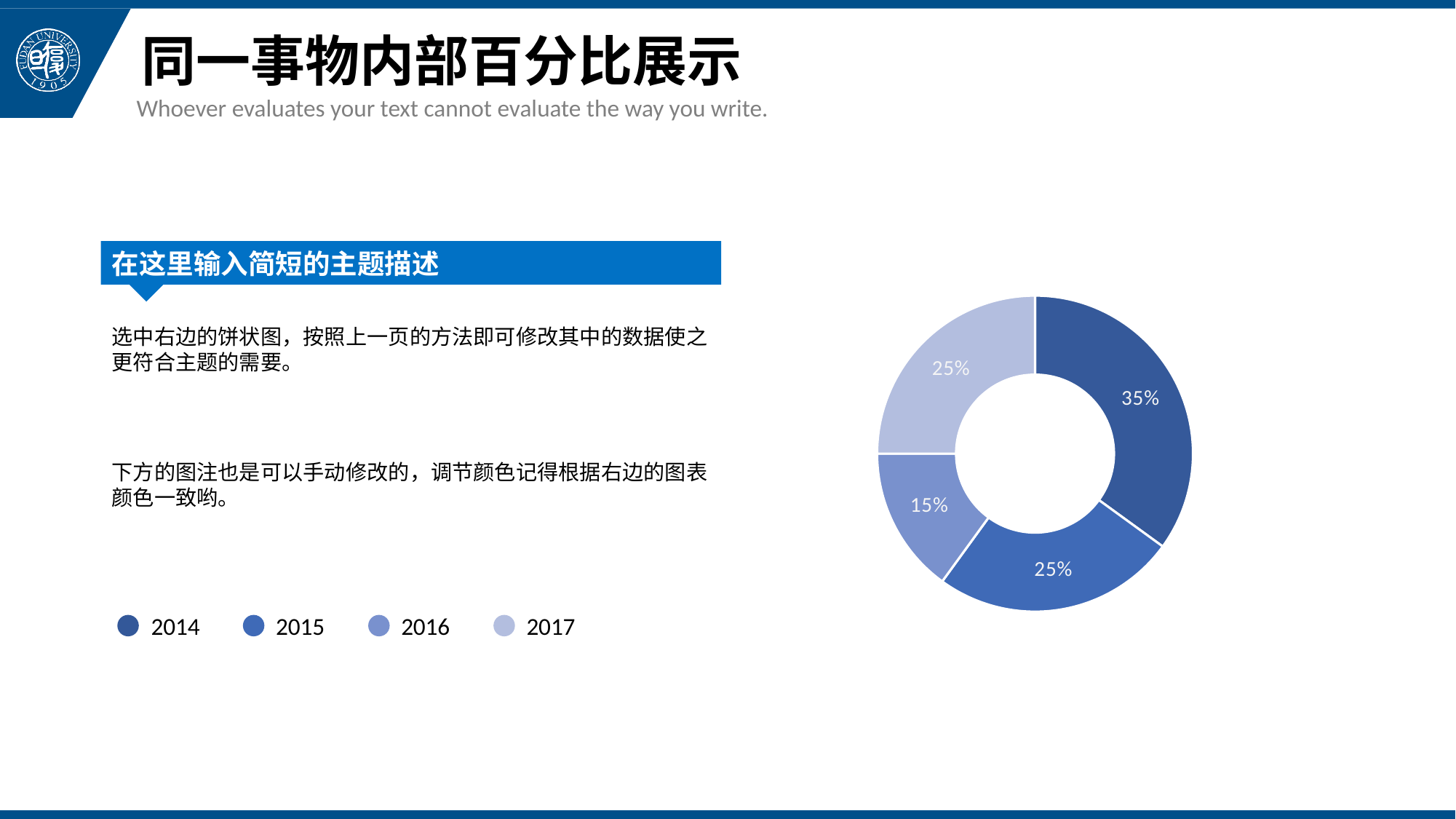
What is the combined share of 2015 and 2017? 50% Which year is shown in the lightest blue in the legend? 2017 What percentage does the 2016 slice show? 15% What kind of chart is shown on the slide? Doughnut (pie) chart Which year has the smallest share of the doughnut chart? 2016 What percentage does the 2014 slice show? 35% How many entries does the legend list? 4 Which is larger, the share for 2015 or the share for 2016? 2015 Which year has the largest share of the doughnut chart? 2014 What is the difference between the 2014 share and the 2016 share? 20% How many slices does the doughnut chart have? 4 What percentage does the 2017 slice show? 25%